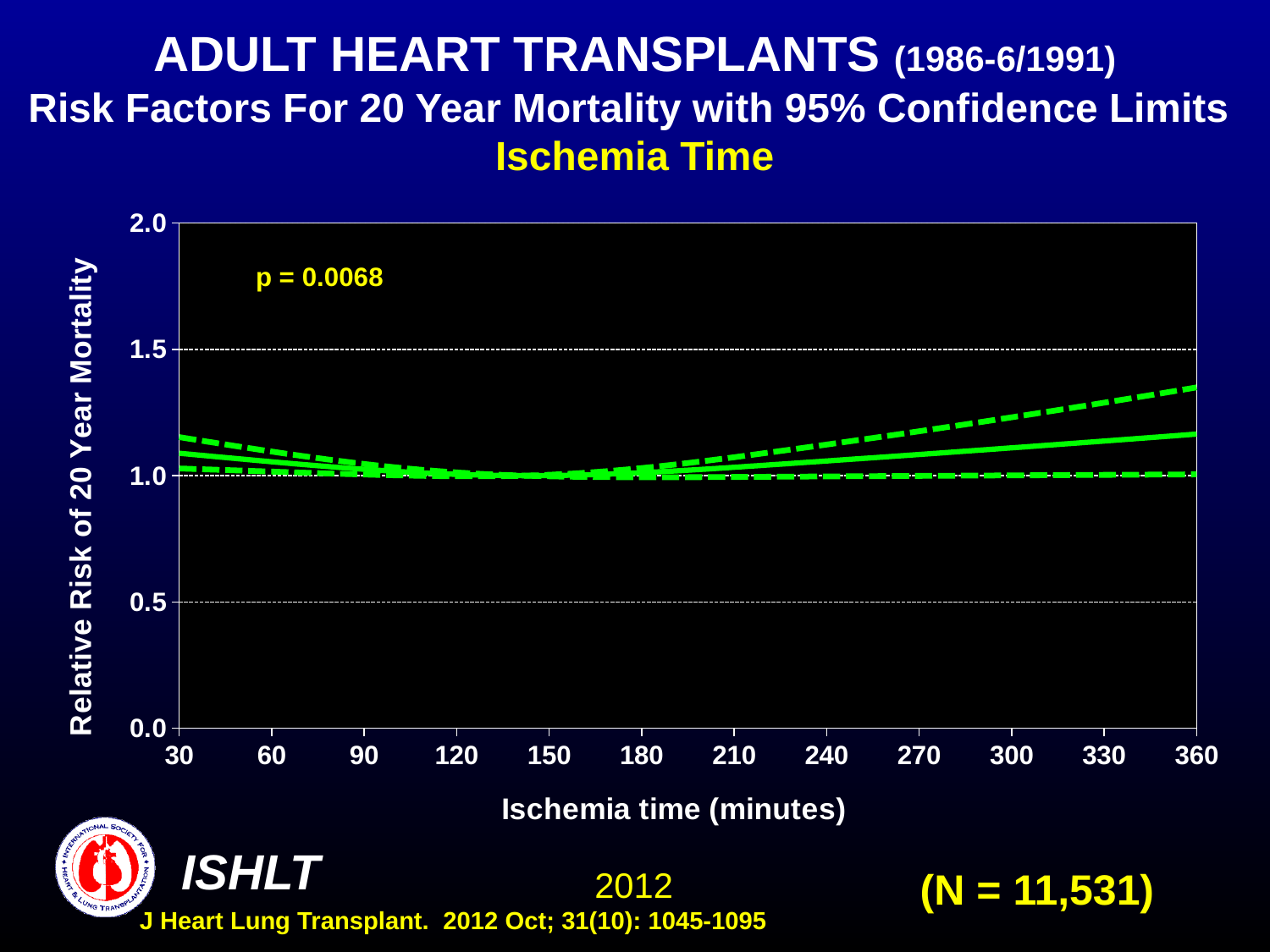
What p-value is printed on the chart? p = 0.0068 Is the solid relative risk line at 360 minutes of ischemia time greater or less than 1.5? less Is the upper dashed confidence limit at 360 minutes greater or less than 1.5? less Which is larger at 360 minutes: the upper dashed confidence limit or the solid relative risk line? the upper dashed confidence limit Is the solid relative risk line at 360 minutes greater or less than 0.5? greater What is the sample size (N) shown on the slide? N = 11,531 What kind of chart is shown on the slide? line chart How many tick labels are shown on the x axis (ischemia time)? 12 How many lines are plotted on the chart? 3 Does the solid relative risk line rise or fall as ischemia time increases from 180 to 360 minutes? rise